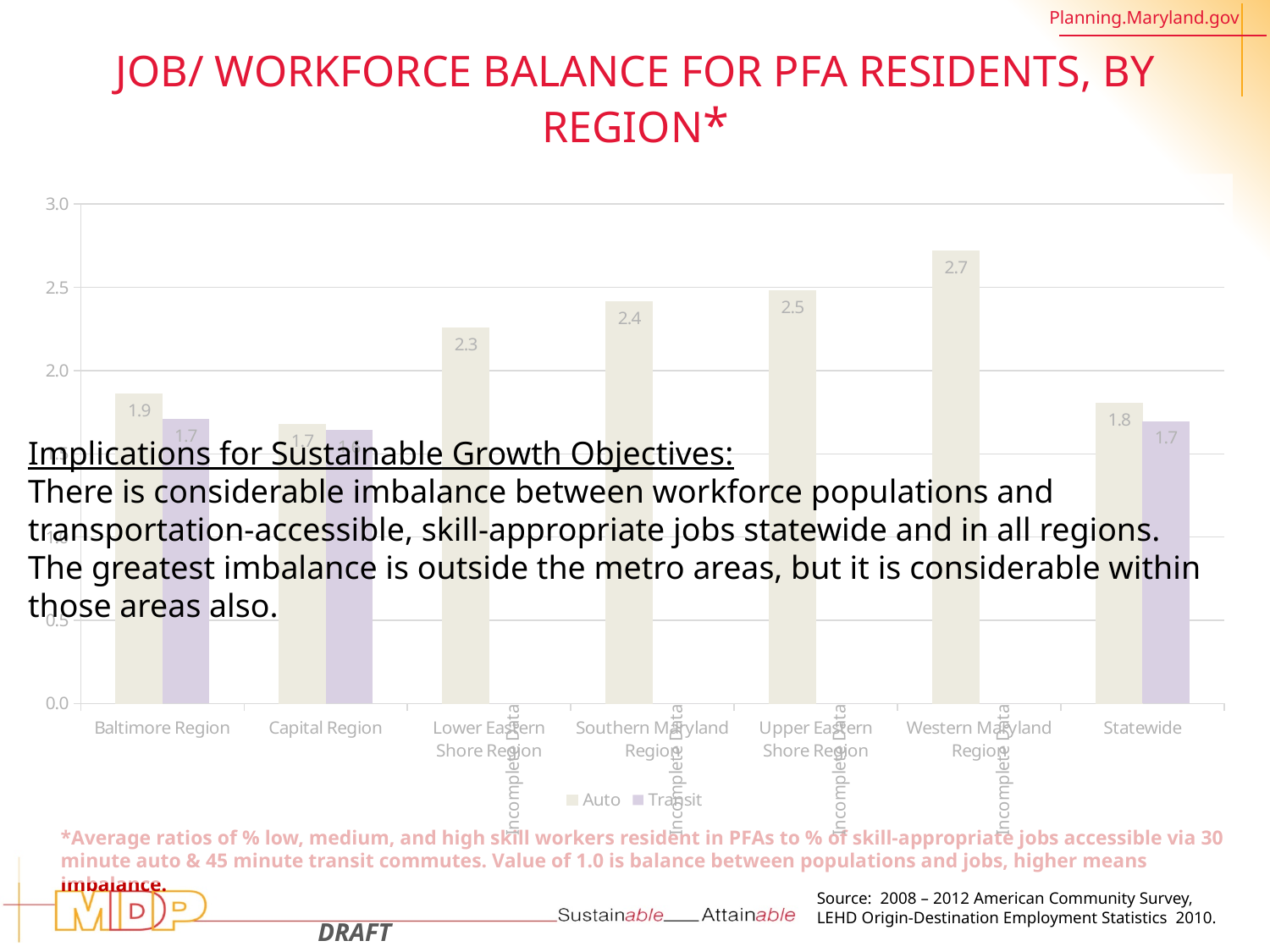
What kind of chart is shown on the slide? Bar chart What is the Auto value for the Western Maryland Region? 2.7 What is the Auto value for the Baltimore Region? 1.9 Is the Auto value for the Statewide category greater or less than 2.0? less What is the Auto value for the Upper Eastern Shore Region? 2.5 How many regions (categories) are shown on the x axis? 7 What is the Transit value for Statewide? 1.7 Which region has the highest Auto value? Western Maryland Region Which is larger, the Auto value for the Southern Maryland Region or the Auto value for the Lower Eastern Shore Region? Southern Maryland Region What is the difference between the Auto values for the Western Maryland Region and the Baltimore Region? 0.8 How many series does the legend list? 2 Which region has the lowest Auto value? Capital Region